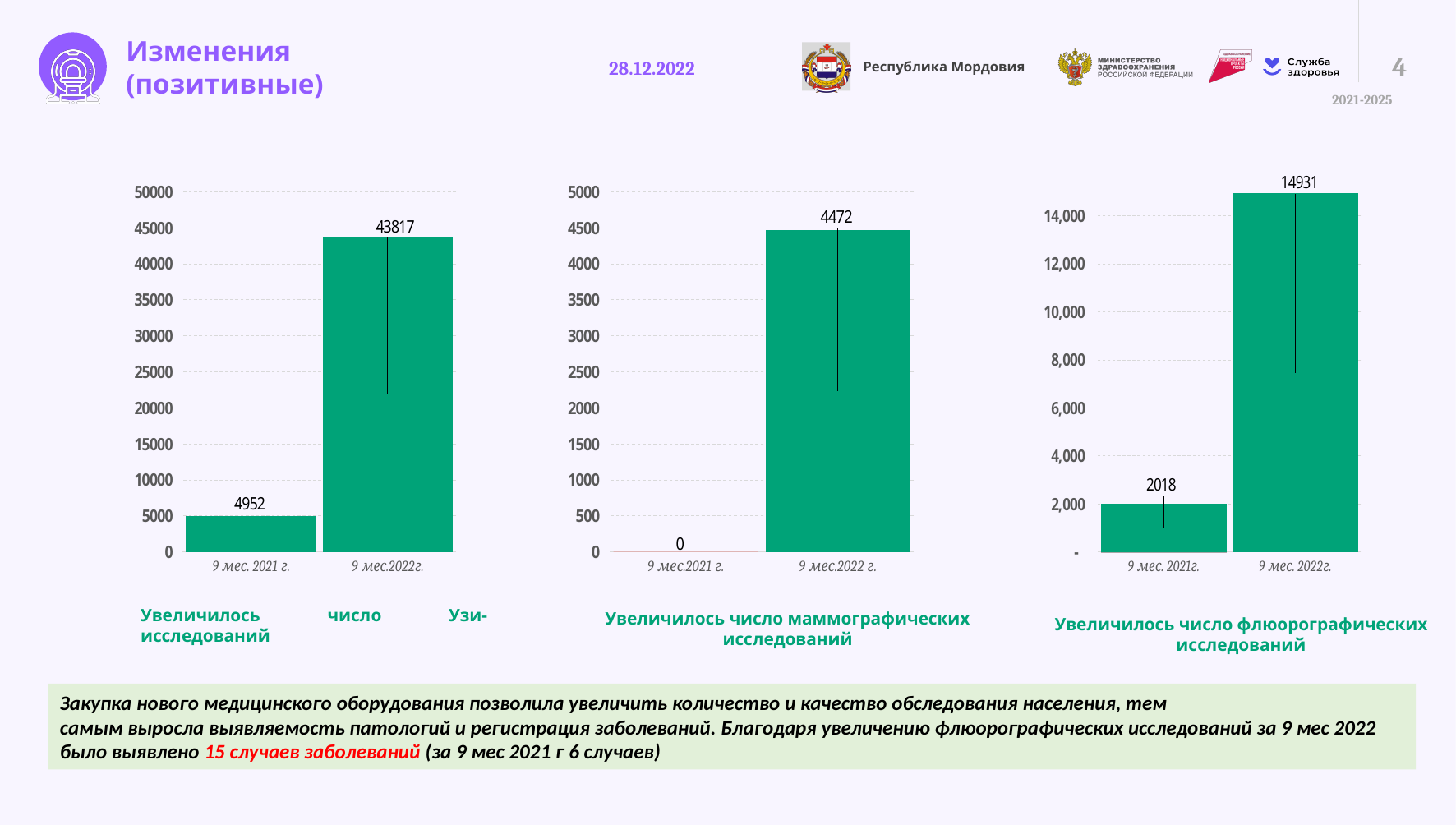
In the right chart (fluorography studies), what is the value for 9 мес. 2021 г.? 2018 In the left chart (ultrasound studies), is the value for 9 мес. 2021 г. greater or less than 10000? less In the middle chart (mammography studies), what is the value for 9 мес. 2022 г.? 4472 In the middle chart (mammography studies), what is the value for 9 мес. 2021 г.? 0 What type of chart is used for the mammography studies in the middle? bar chart In the right chart (fluorography studies), which period has the higher value? 9 мес. 2022 г. How many categories are shown on the x axis of the middle chart (mammography studies)? 2 In the right chart (fluorography studies), what is the value for 9 мес. 2022 г.? 14931 In the left chart (ultrasound studies), what is the difference between the 2022 and 2021 values? 38865 In the left chart (ultrasound studies), what is the value for 9 мес. 2021 г.? 4952 In the right chart (fluorography studies), what is the difference between the 2022 and 2021 values? 12913 In the left chart (ultrasound studies), what is the value for 9 мес. 2022 г.? 43817